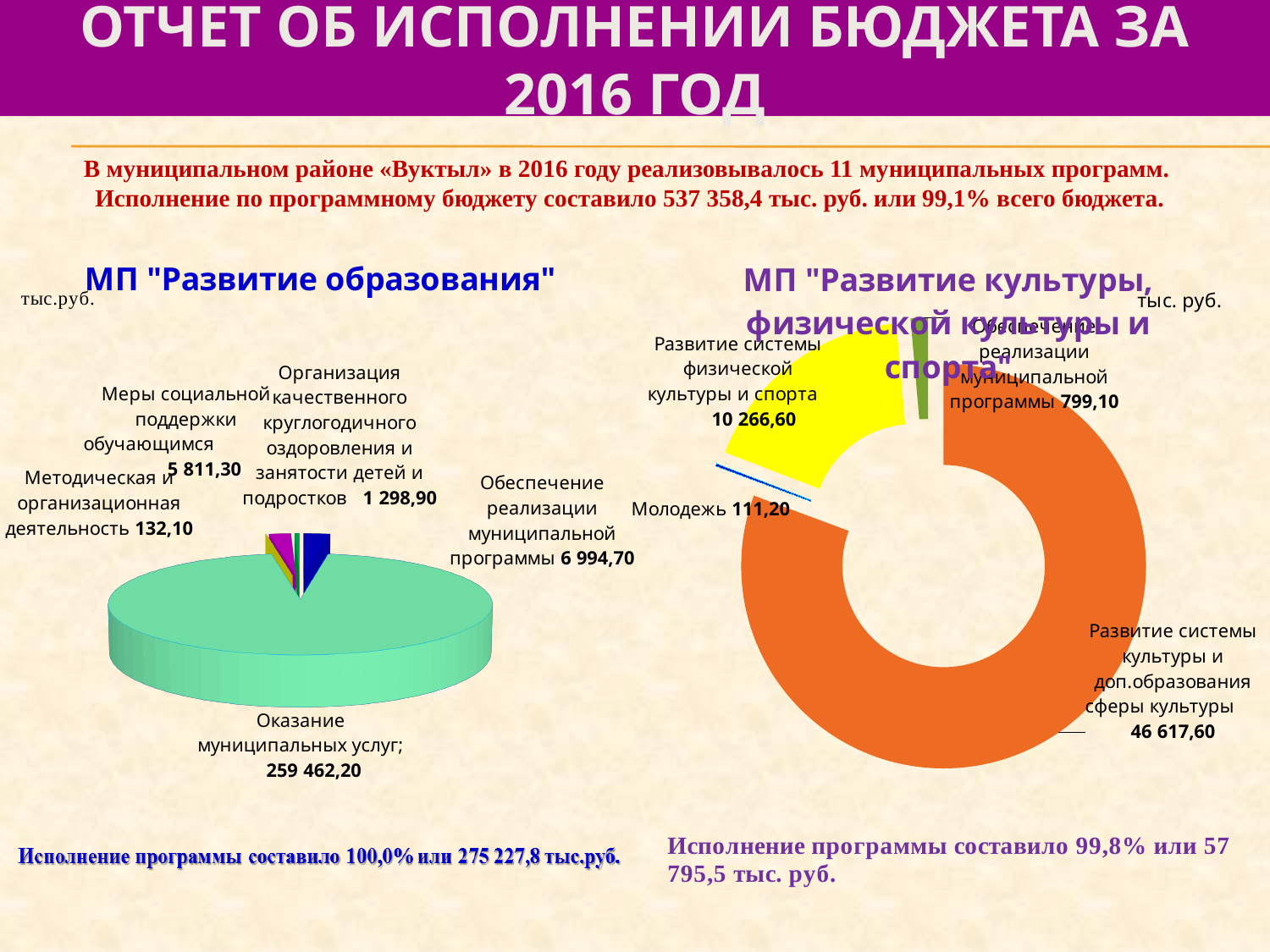
In the chart "МП "Развитие образования"", how many categories are shown? 5 What kind of chart is "МП "Развитие образования""? Pie chart In the chart "МП "Развитие культуры, физической культуры и спорта"", which is larger: "Обеспечение реализации муниципальной программы" or "Молодежь"? Обеспечение реализации муниципальной программы In the chart "МП "Развитие образования"", what is the difference between "Меры социальной поддержки обучающимся" and "Организация качественного круглогодичного оздоровления и занятости детей и подростков"? 4 512,40 In the chart "МП "Развитие культуры, физической культуры и спорта"", what is the difference between "Развитие системы культуры и доп.образования сферы культуры" and "Развитие системы физической культуры и спорта"? 36 351,00 In the chart "МП "Развитие образования"", which category has the largest value? Оказание муниципальных услуг In the chart "МП "Развитие культуры, физической культуры и спорта"", what is the value for "Развитие системы физической культуры и спорта"? 10 266,60 In the chart "МП "Развитие культуры, физической культуры и спорта"", what is the value for "Молодежь"? 111,20 In the chart "МП "Развитие культуры, физической культуры и спорта"", which category has the largest value? Развитие системы культуры и доп.образования сферы культуры In the chart "МП "Развитие образования"", which category has the smallest value? Методическая и организационная деятельность In the chart "МП "Развитие образования"", what is the value for "Методическая и организационная деятельность"? 132,10 In the chart "МП "Развитие образования"", what is the value for "Оказание муниципальных услуг"? 259 462,20